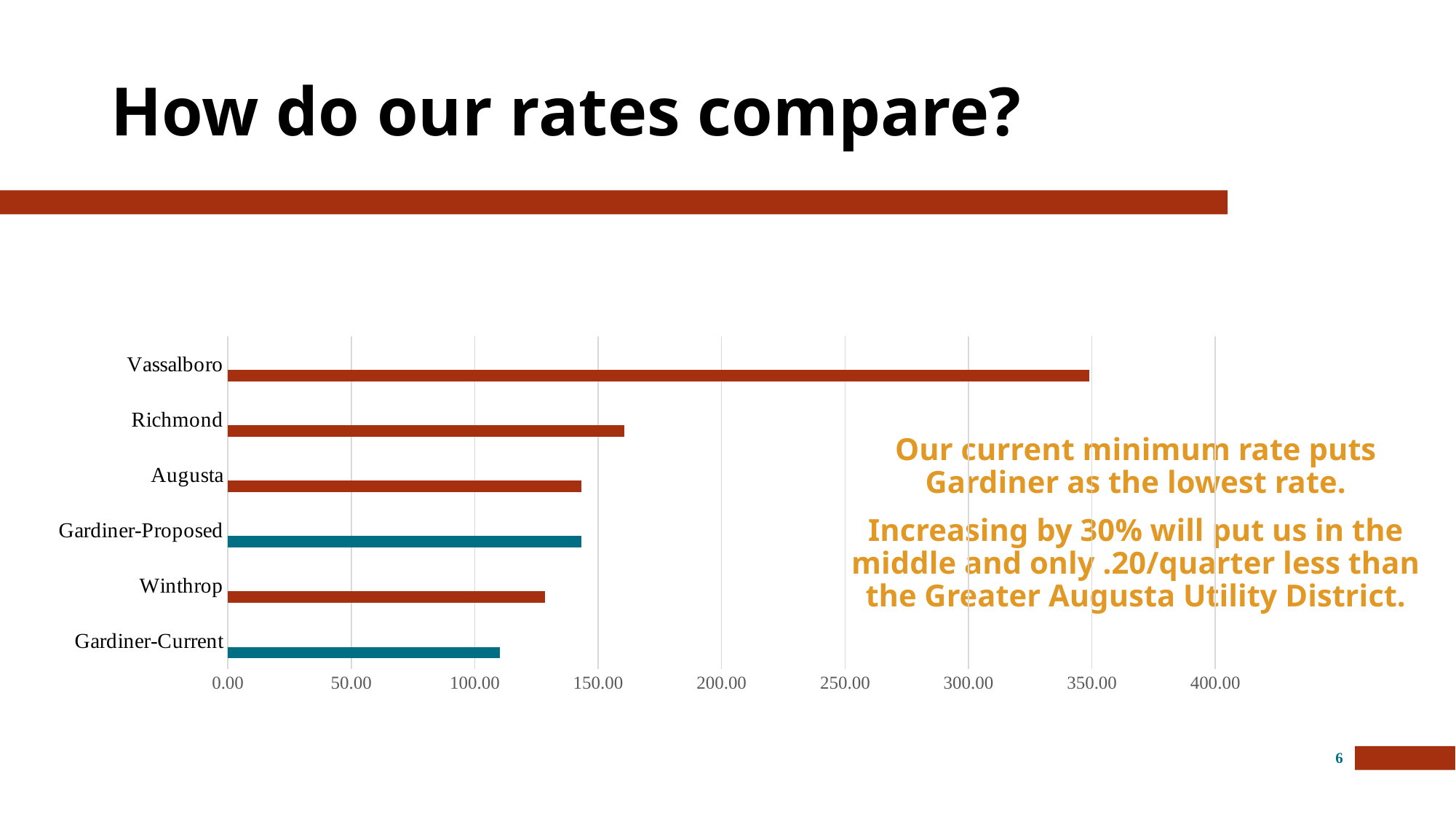
How many categories are plotted in the chart? 6 What kind of chart is shown on the slide? bar chart Which is larger, the value for Richmond or the value for Augusta? Richmond Which is larger, the value for Winthrop or the value for Gardiner-Current? Winthrop Which category has the highest value in the chart? Vassalboro Is the value for Richmond greater or less than 150.00? greater Which two categories are drawn in a different colour (teal) from the other bars? Gardiner-Proposed and Gardiner-Current Is the value for Vassalboro greater or less than 300.00? greater Is the value for Gardiner-Current greater or less than 150.00? less Which category has the lowest value in the chart? Gardiner-Current